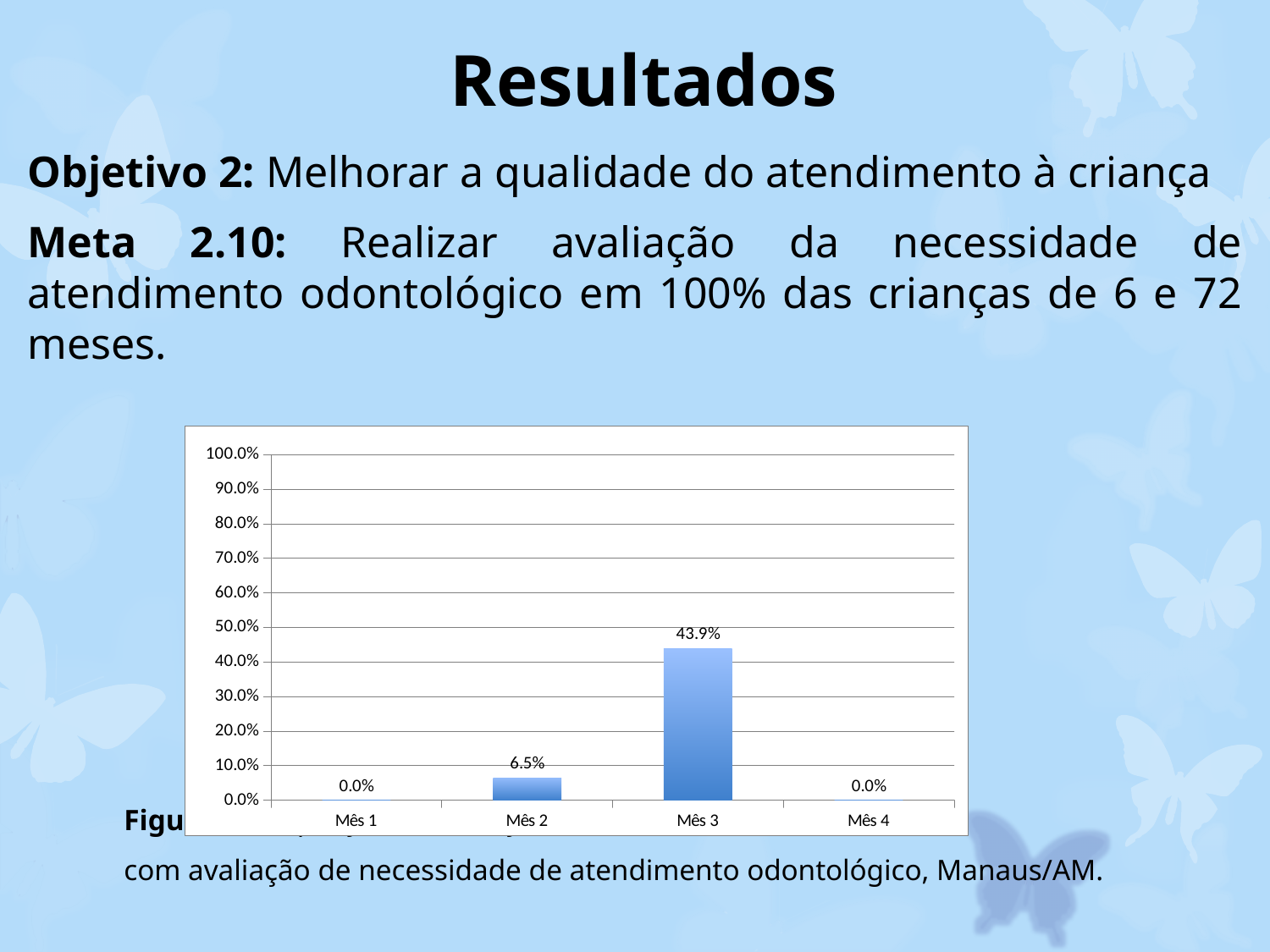
Which is larger, the value for Mês 2 or the value for Mês 3? Mês 3 Is the value for Mês 3 greater or less than 50%? less What is the difference between the values for Mês 3 and Mês 2? 37.4% What kind of chart is shown on the slide? bar chart What is the highest value shown on the y axis of the chart? 100.0% How many months are shown on the x axis of the chart? 4 Is the value for Mês 2 greater or less than 10%? less What is the value for Mês 1? 0.0% What is the value for Mês 4? 0.0% Which month has the highest value? Mês 3 What is the value for Mês 3? 43.9% What is the value for Mês 2? 6.5%